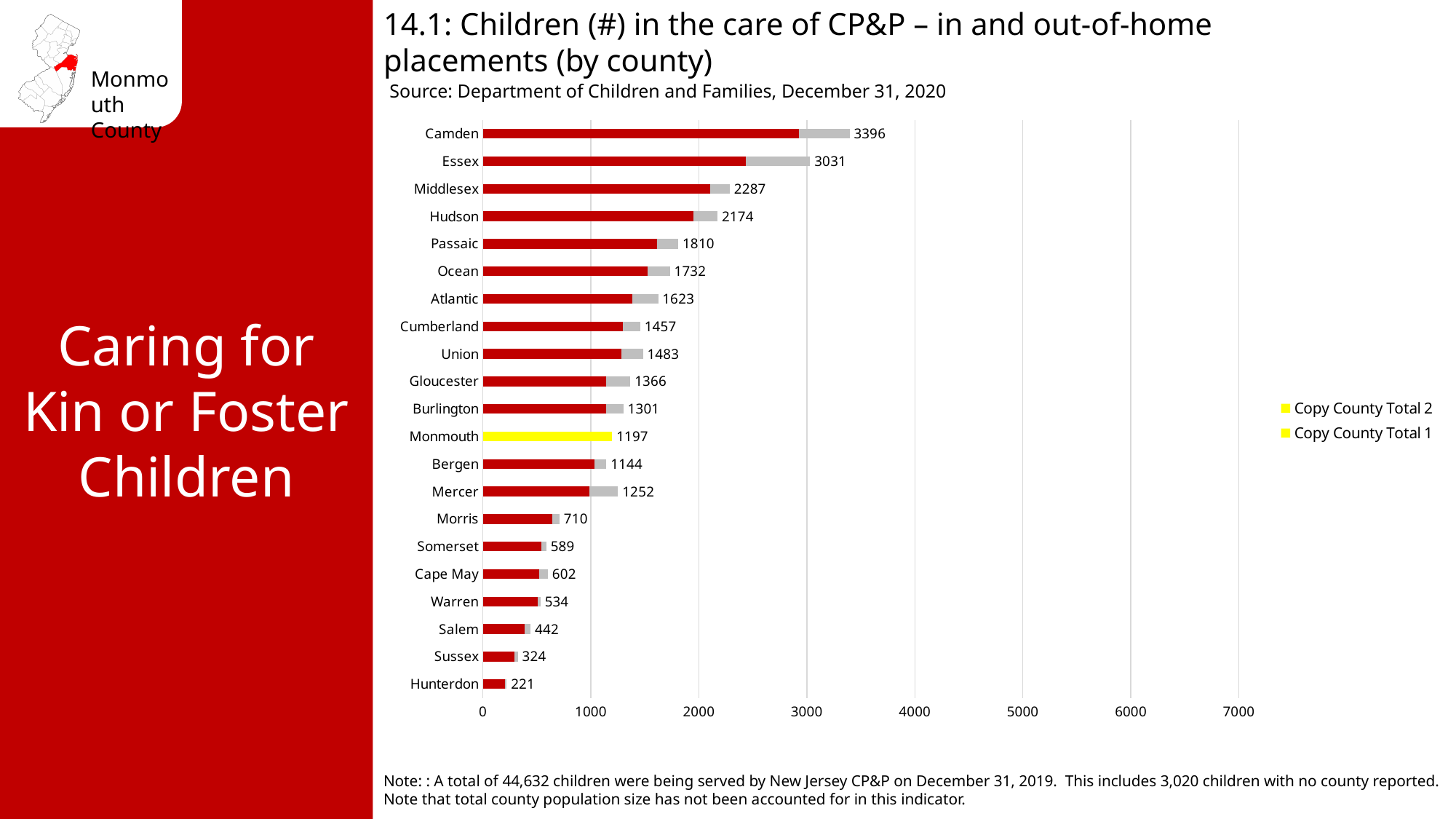
Is the total for Middlesex greater or less than 2000? greater How many counties are shown in the chart? 21 Which county's bar is highlighted in yellow? Monmouth Which county has the lowest total number of children in the care of CP&P? Hunterdon What is the total value shown for Monmouth? 1197 How many series does the legend list? 2 What is the total value shown for Hunterdon? 221 What kind of chart is shown on the slide? Bar chart Which county has a larger total, Mercer or Bergen? Mercer Which county has the highest total number of children in the care of CP&P? Camden What is the difference between the totals for Camden and Essex? 365 What is the total number of children in the care of CP&P for Camden? 3396